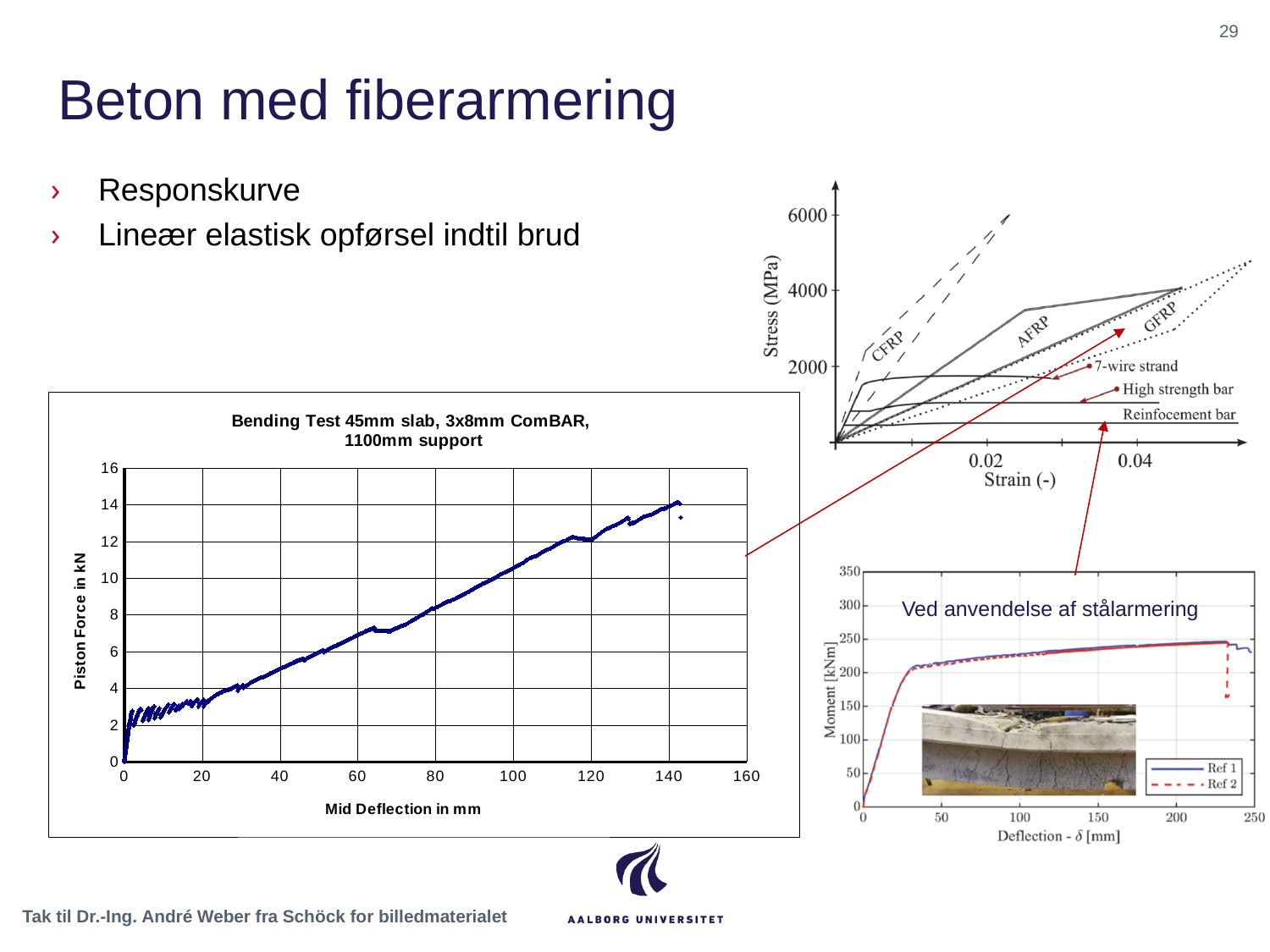
In the stress-strain chart at the top right, which material has the lowest stress? Reinfocement bar In the 'Bending Test 45mm slab' chart, does the piston force rise or fall as mid deflection increases? rise What is the highest tick value on the x axis of the 'Bending Test 45mm slab' chart? 160 In the moment-deflection chart at the bottom right, how many series does the legend list? 2 In the stress-strain chart at the top right, how many materials are labelled? 6 In the 'Bending Test 45mm slab' chart, is the piston force at a mid deflection of 60 mm greater or less than 6 kN? greater In the moment-deflection chart at the bottom right, is the peak moment of Ref 1 greater or less than 200 kNm? greater What is the label of the y axis in the 'Bending Test 45mm slab' chart? Piston Force in kN What kind of chart is the 'Bending Test 45mm slab, 3x8mm ComBAR, 1100mm support' chart? line chart In the stress-strain chart at the top right, which material reaches the highest stress? CFRP In the 'Bending Test 45mm slab' chart, is the piston force at a mid deflection of 140 mm greater or less than 12 kN? greater